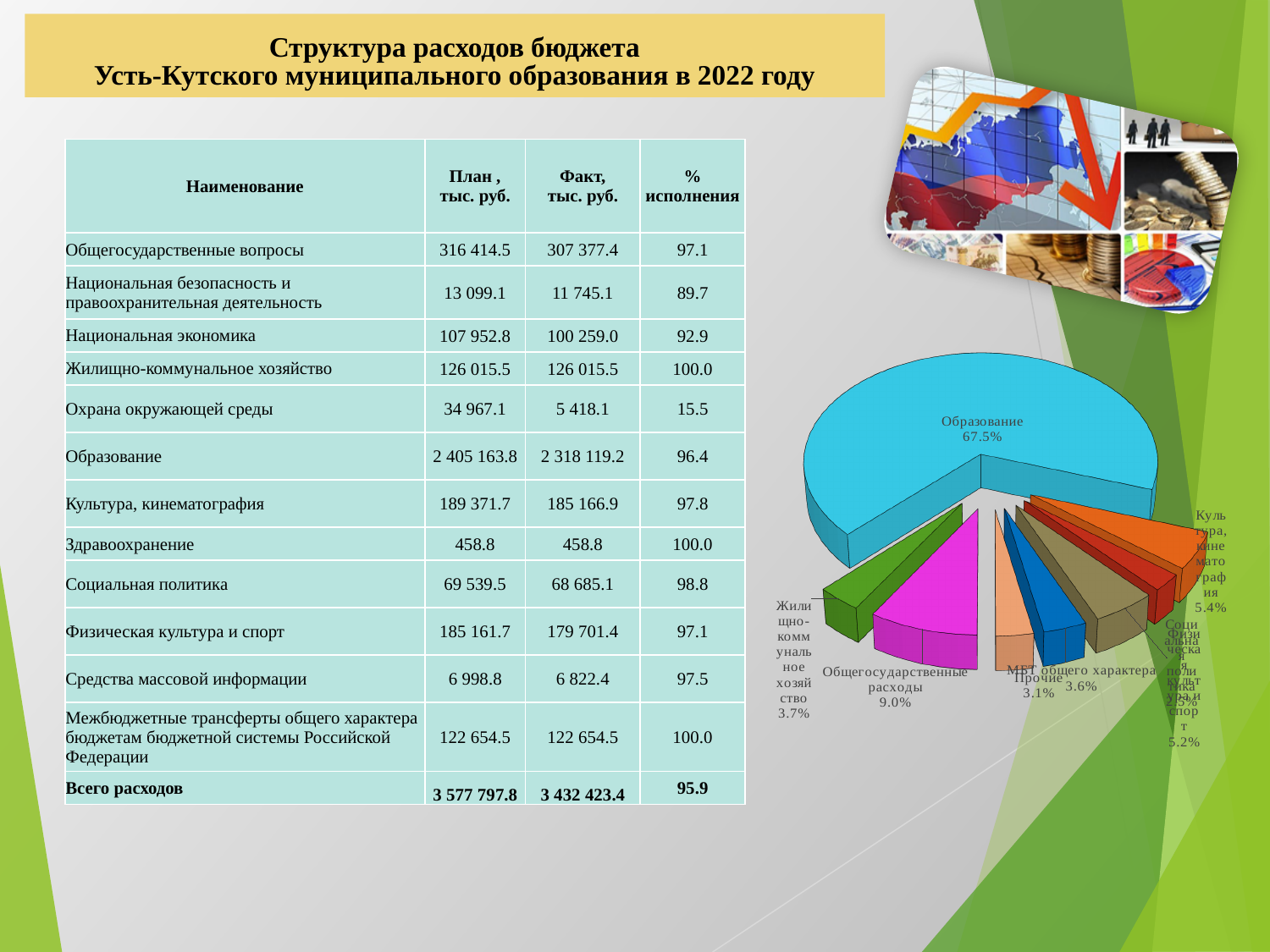
What kind of chart is shown on the slide? pie chart What share of the pie chart does МБТ общего характера have? 3.6% Which category has the largest share of the pie chart? Образование What share of the pie chart does Жилищно-коммунальное хозяйство have? 3.7% What share of the pie chart does Культура, кинематография have? 5.4% Which has a larger share in the pie chart, Жилищно-коммунальное хозяйство or Прочие? Жилищно-коммунальное хозяйство What share of the pie chart does Прочие have? 3.1% What is the difference in percentage points between the shares of Образование and Общегосударственные расходы? 58.5% Which has a larger share in the pie chart, Общегосударственные расходы or Культура, кинематография? Общегосударственные расходы What share of the pie chart does Физическая культура и спорт have? 5.2% What share of the pie chart does Образование have? 67.5% What share of the pie chart does Общегосударственные расходы have? 9.0%